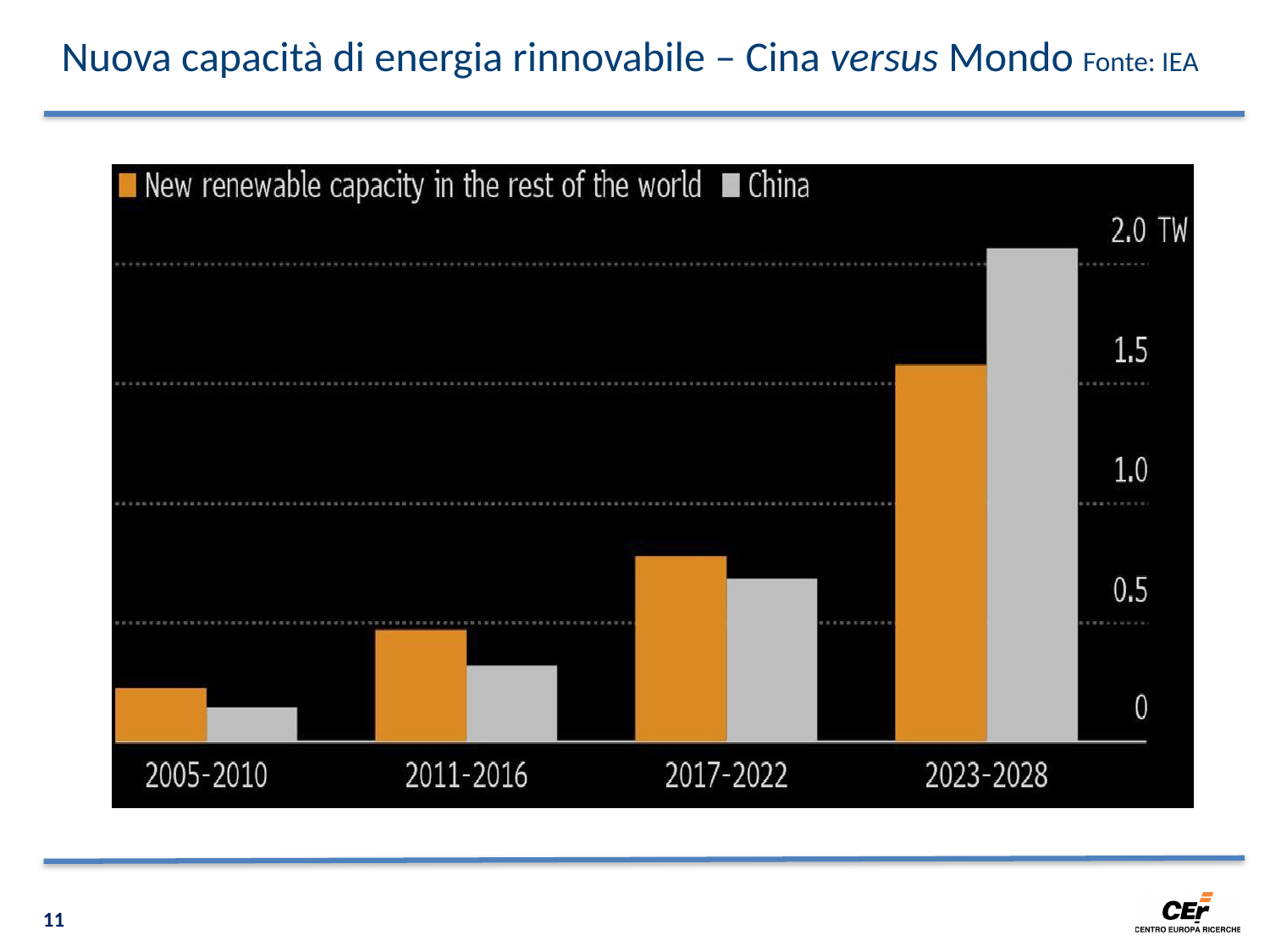
In 2023-2028, which is larger: new renewable capacity in China or in the rest of the world? China Is the value for the rest of the world in 2023-2028 greater or less than 1.0 TW? greater Do the China bars rise or fall from 2005-2010 to 2023-2028? rise Which period has the lowest bar for China? 2005-2010 Is the value for China in 2005-2010 greater or less than 0.5 TW? less What kind of chart is shown on the slide? bar chart How many time periods are shown on the x axis? 4 What colour represents China in the legend? grey In 2017-2022, which is larger: new renewable capacity in China or in the rest of the world? rest of the world How many series does the legend list? 2 Is the value for China in 2017-2022 greater or less than 0.5 TW? greater Which period has the highest bar for China? 2023-2028